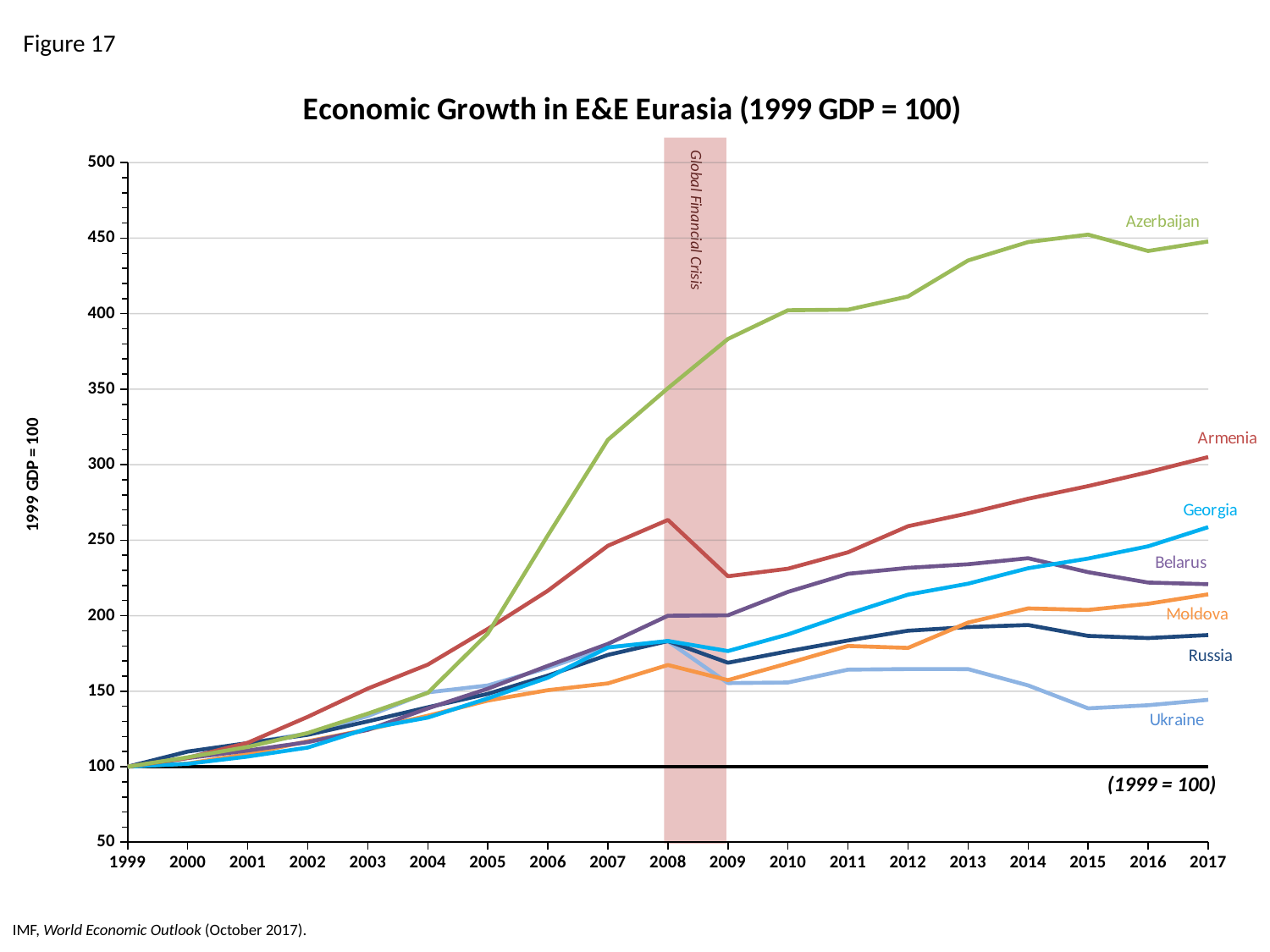
Is the value for Russia in 2017 greater or less than 200? less Is the value for Azerbaijan in 2017 greater or less than 400? greater Does the value for Azerbaijan generally rise or fall from 1999 to 2017? rise What event does the shaded vertical band on the chart mark? Global Financial Crisis What is the value for every country in 1999? 100 Is the value for Ukraine in 2015 greater or less than 150? less How many years are shown along the x axis of the chart? 19 How many countries are plotted in the chart? 7 Which country has the lowest value in 2017? Ukraine In 2017, which is larger, the value for Georgia or the value for Belarus? Georgia What kind of chart is shown on the slide? Line chart Which country has the highest value in 2017? Azerbaijan